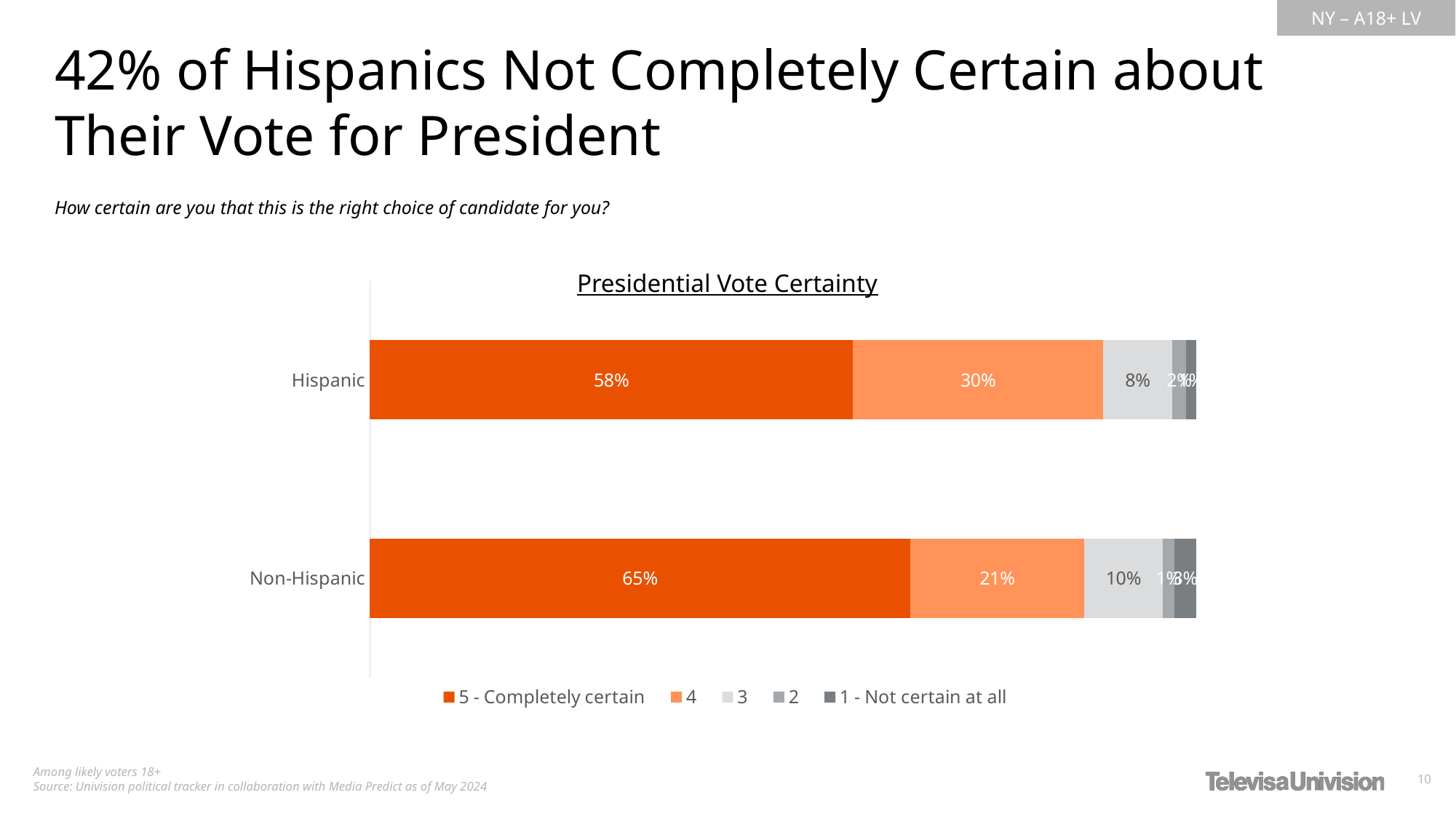
What type of chart is shown on the slide? Stacked bar chart What percentage of Hispanic likely voters are "5 - Completely certain" about their vote for president? 58% How many categories (groups) are shown in the chart? 2 How many series does the legend list? 5 What is the value of the "4" series for the Hispanic bar? 30% What is the value of the "3" series for the Hispanic bar? 8% What is the value of the "4" series for the Non-Hispanic bar? 21% Which group has the larger share of "5 - Completely certain" respondents, Hispanic or Non-Hispanic? Non-Hispanic What is the value of the "3" series for the Non-Hispanic bar? 10% What percentage of Non-Hispanic likely voters are "5 - Completely certain"? 65% How many percentage points higher is the "5 - Completely certain" share for Non-Hispanic than for Hispanic? 7 Which series is the largest segment of the Hispanic bar? 5 - Completely certain